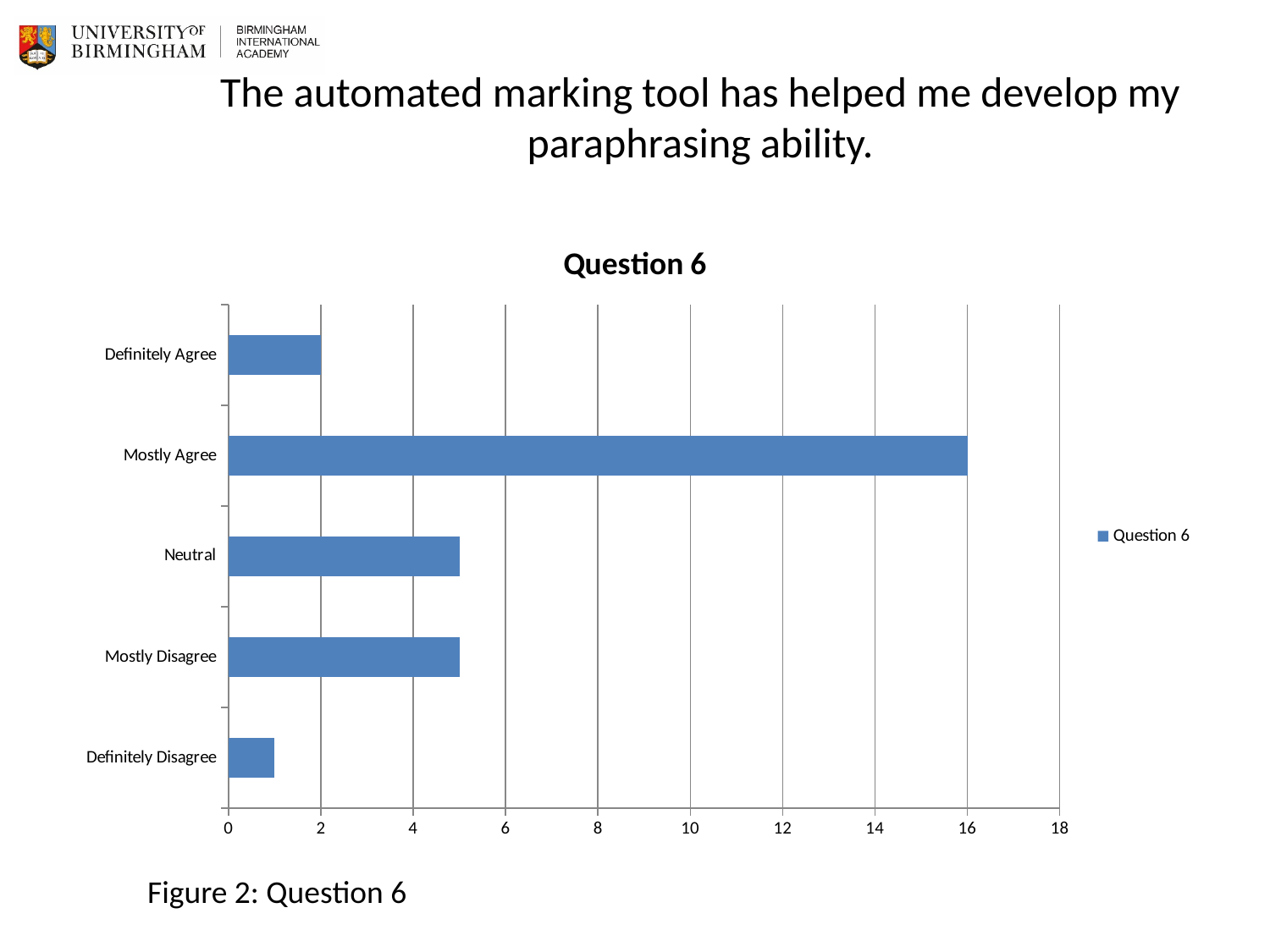
What type of chart is shown on the slide? bar chart How many categories are shown on the chart? 5 What is the value for Mostly Agree? 16 Is the value for Definitely Disagree greater or less than 2? less Which category has the lowest value? Definitely Disagree Which is larger, the value for Mostly Agree or the value for Neutral? Mostly Agree How many series does the legend list? 1 Is the value for Neutral greater or less than 4? greater What is the title of the chart? Question 6 Which category has the highest value? Mostly Agree What is the value for Definitely Agree? 2 What is the difference between the values for Mostly Agree and Definitely Agree? 14